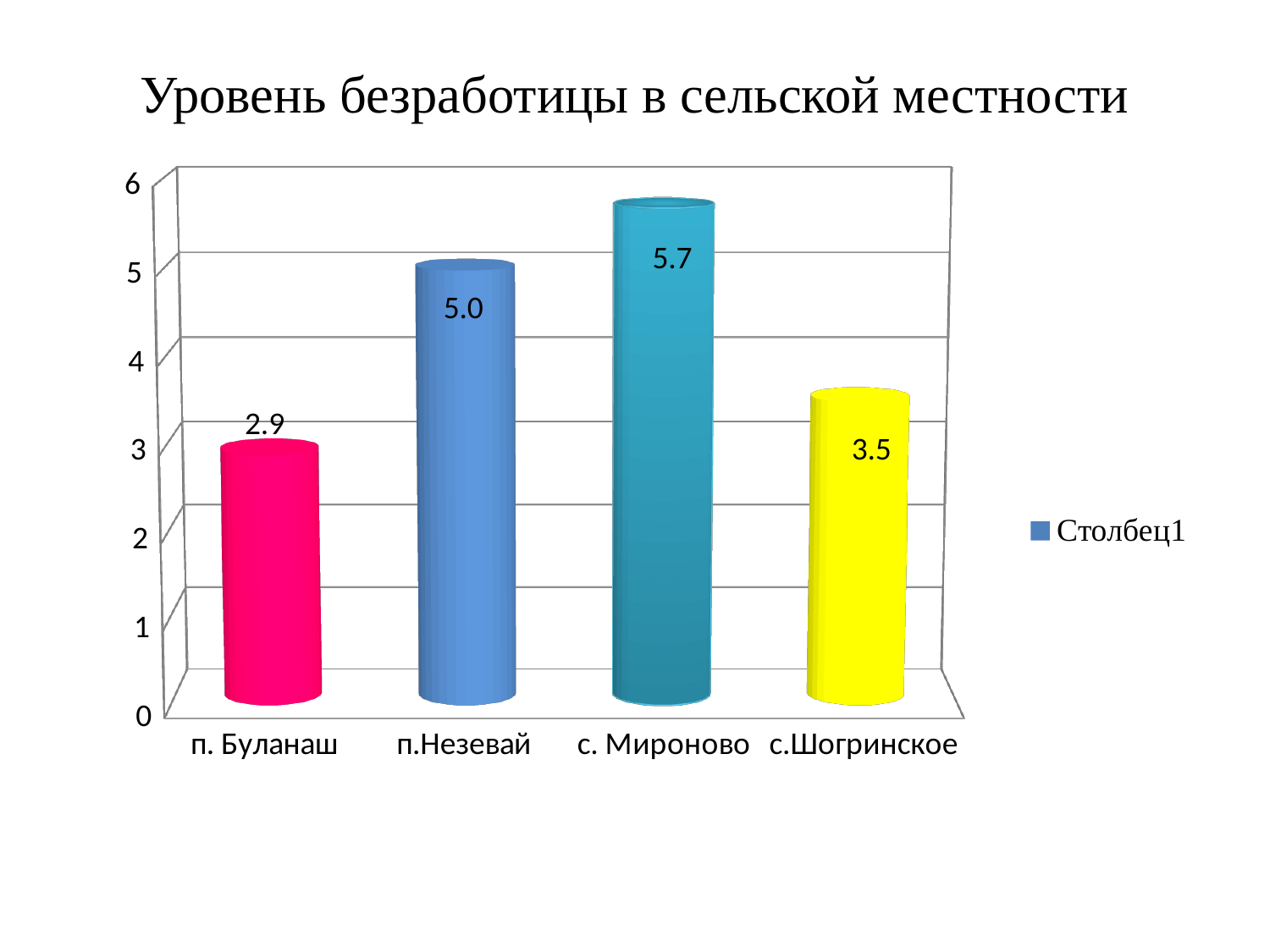
What kind of chart is this? bar chart How many categories are shown on the x axis? 4 What is the value for с.Шогринское? 3.5 Which is larger, the value for с.Шогринское or the value for п. Буланаш? с.Шогринское What is the difference between the values for п.Незевай and с.Шогринское? 1.5 What is the value for с. Мироново? 5.7 Which category has the highest value? с. Мироново What is the value for п.Незевай? 5.0 What is the title of the chart? Уровень безработицы в сельской местности What is the value for п. Буланаш? 2.9 Which category has the lowest value? п. Буланаш What is the difference between the values for с. Мироново and п. Буланаш? 2.8